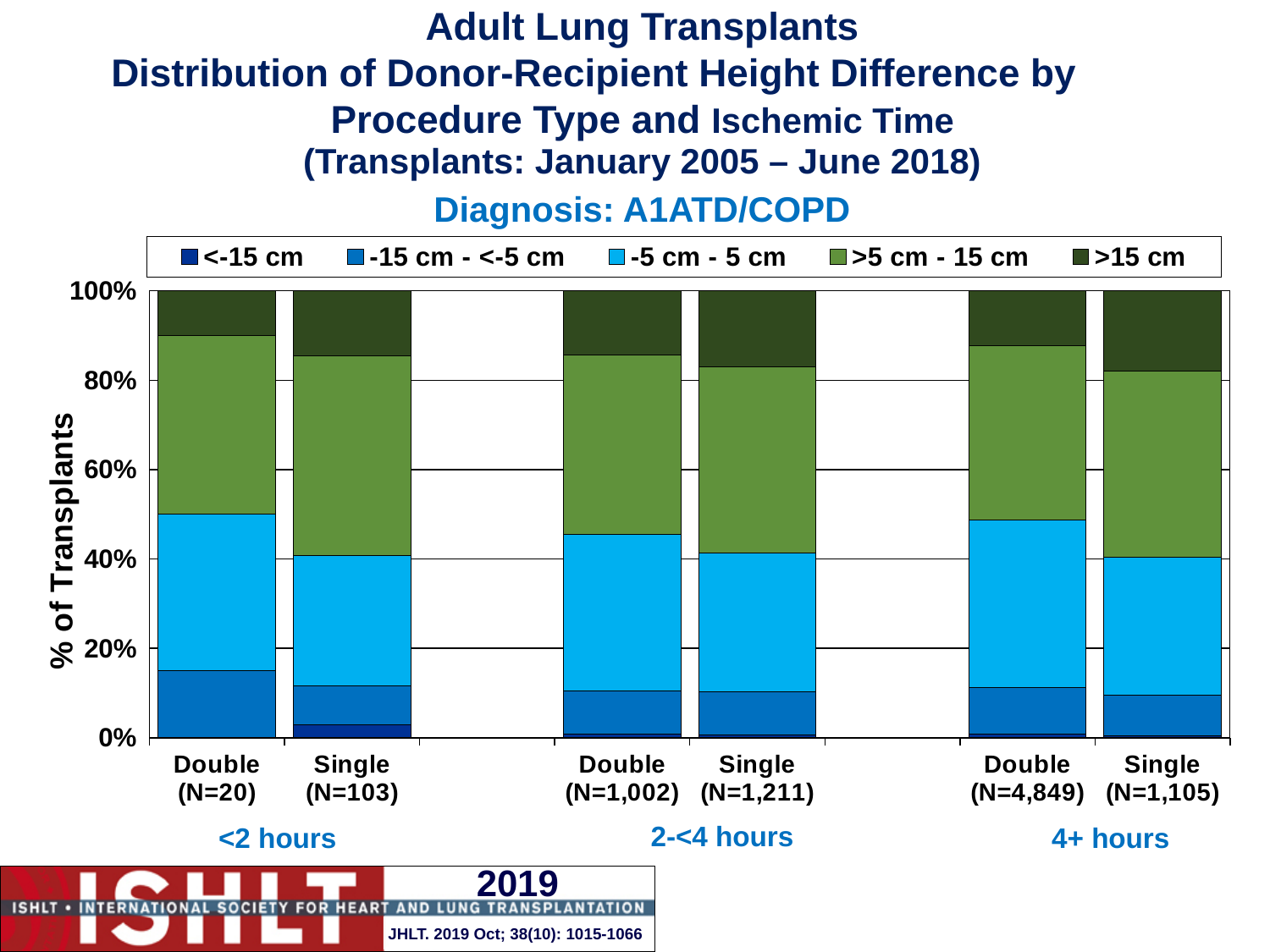
How many ischemic time groups are shown along the x axis? 3 In the Single (N=1,105) bar, does the top of the >5 cm - 15 cm segment sit above or below 90%? below What diagnosis group does the chart cover, according to the subtitle? A1ATD/COPD What is the total height of the Double (N=20) stacked bar? 100% What kind of chart is shown on the slide? stacked bar chart How many bars are plotted in the chart? 6 In the Double (N=20) bar, is the <-15 cm segment greater or less than 20%? less Which bar has the larger <-15 cm segment: Double (N=20) or Single (N=103)? Single (N=103) Which bar has the larger >15 cm segment: Double (N=4,849) or Single (N=1,105)? Single (N=1,105) In the Double (N=20) bar, does the top of the -15 cm - <-5 cm segment sit above or below 60%? below How many series does the legend list? 5